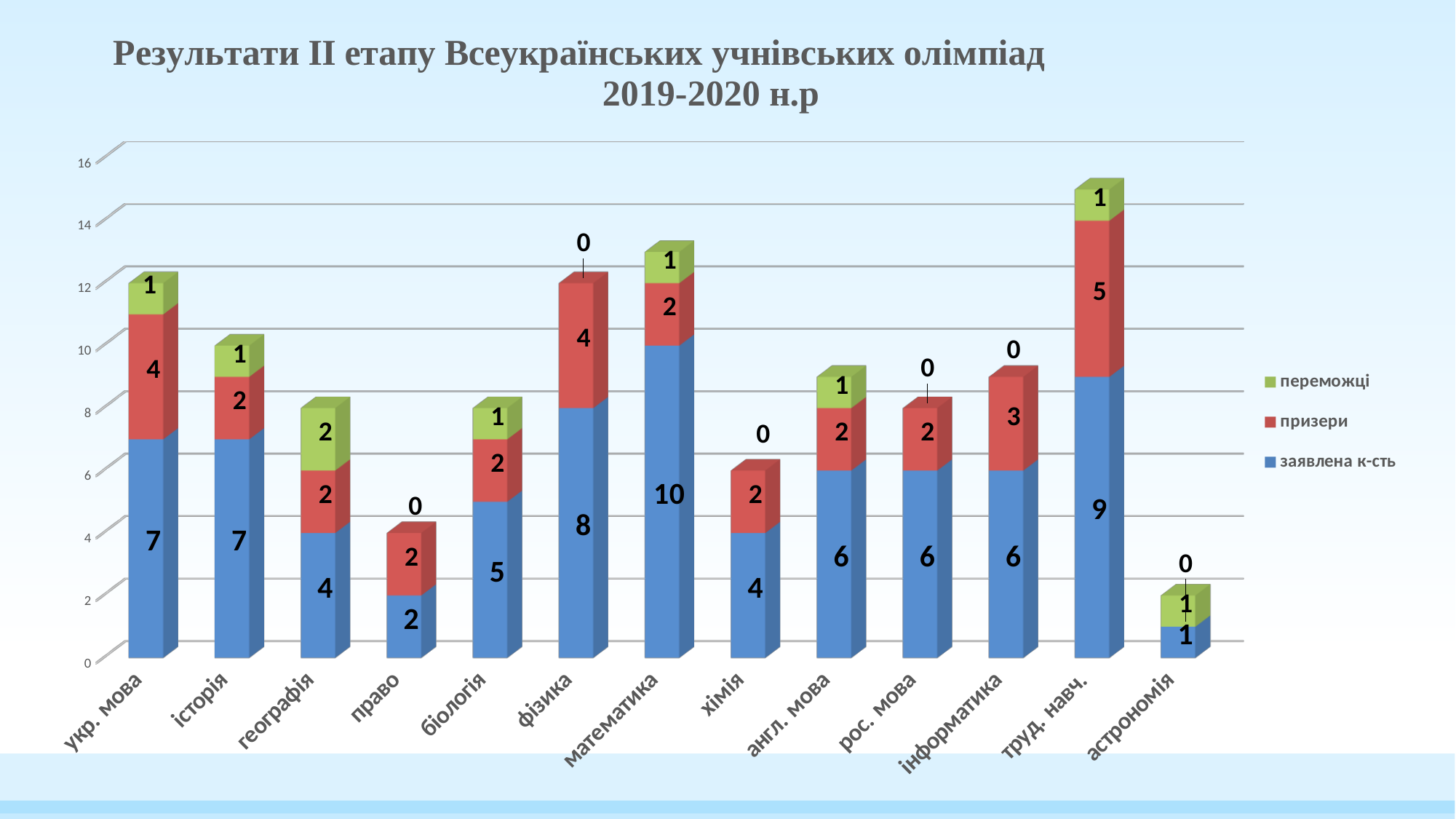
What kind of chart is shown on the slide? Stacked bar chart How many series does the legend list? 3 What is the total of the stacked bar for труд. навч.? 15 What is the difference between the 'заявлена к-сть' values for укр. мова and право? 5 What is the value of 'заявлена к-сть' for математика? 10 What are the three legend entries of the chart? переможці, призери, заявлена к-сть Which subject has the highest 'заявлена к-сть' value? математика Which subject has the highest 'переможці' value? географія How many subject categories are shown on the x axis? 13 What is the value of 'переможці' for географія? 2 Which has the larger 'призери' value, фізика or історія? фізика What is the value of 'призери' for труд. навч.? 5